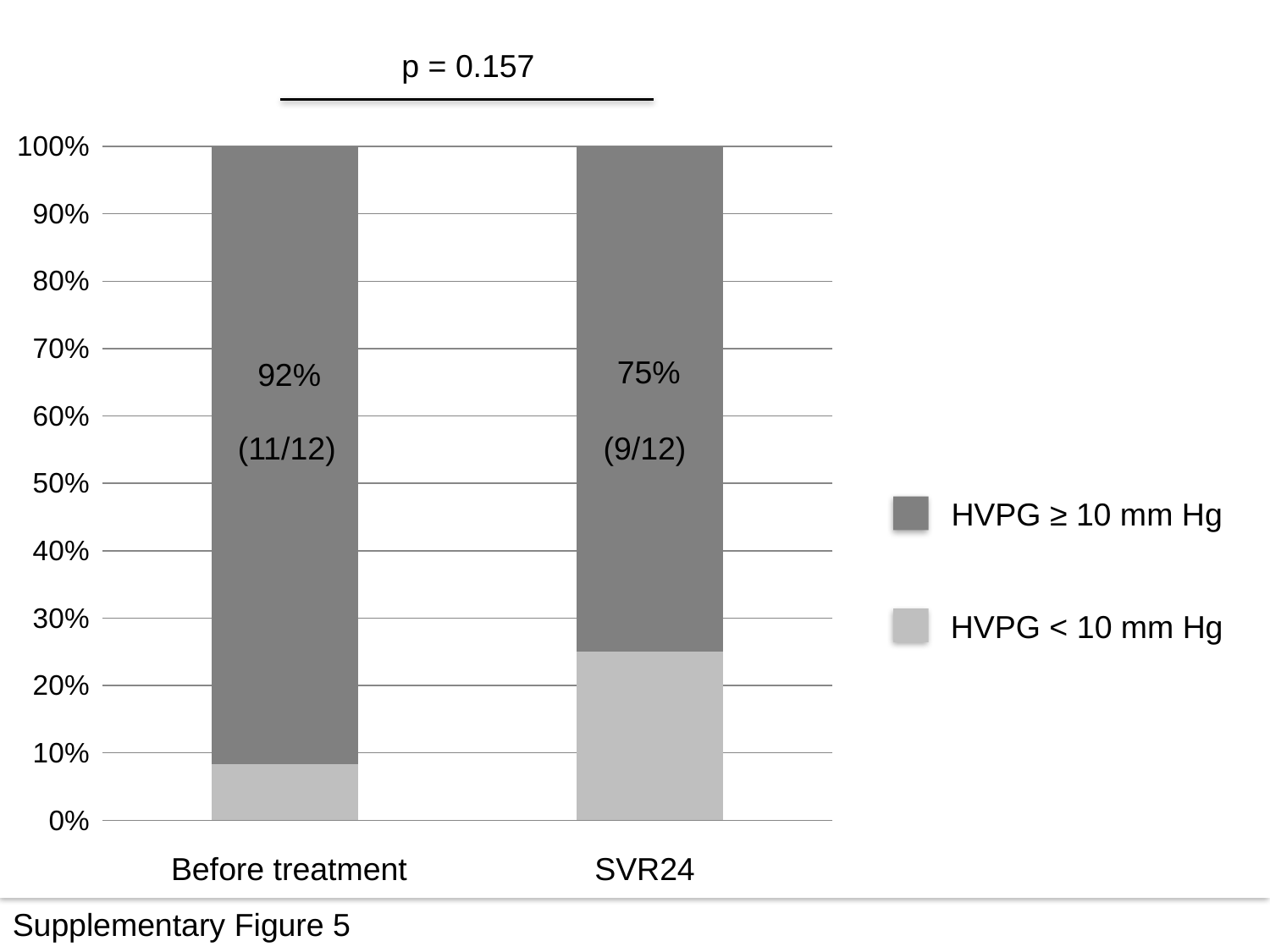
Is the share of patients with HVPG < 10 mm Hg before treatment greater or less than 10%? less By how many percentage points does the HVPG ≥ 10 mm Hg share differ between Before treatment and SVR24? 17% What percentage of patients had HVPG ≥ 10 mm Hg at SVR24? 75% Is the share of patients with HVPG < 10 mm Hg at SVR24 greater or less than 20%? greater What fraction of patients is shown for HVPG ≥ 10 mm Hg at SVR24? 9/12 What kind of chart is shown on the slide? Stacked bar chart What percentage of patients had HVPG ≥ 10 mm Hg before treatment? 92% What p value is shown above the bars? p = 0.157 How many categories are shown on the x axis? 2 How many series does the legend list? 2 Which time point has the larger share of patients with HVPG ≥ 10 mm Hg, Before treatment or SVR24? Before treatment What fraction of patients is shown for HVPG ≥ 10 mm Hg before treatment? 11/12